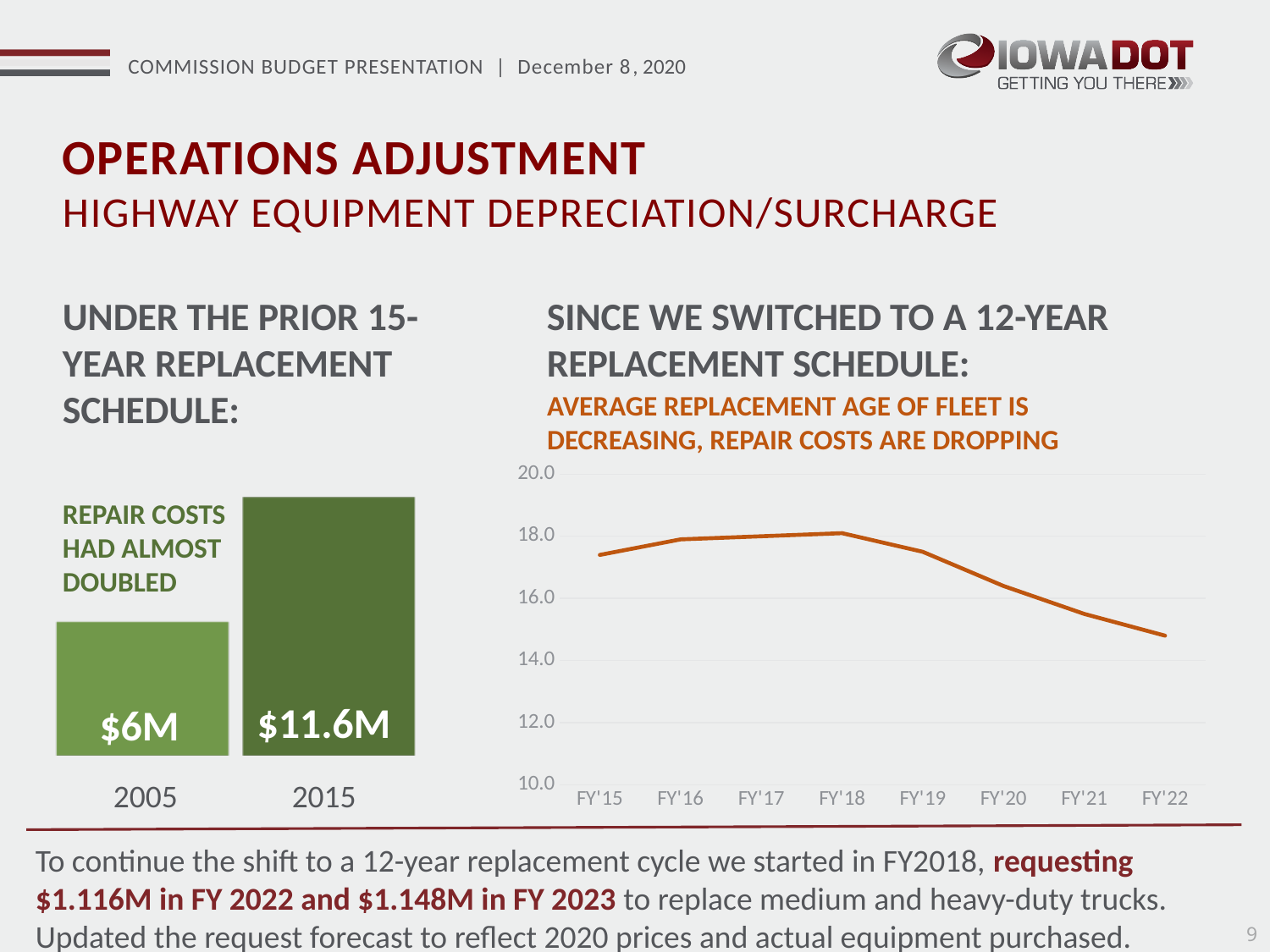
In the bar chart on the left, what were the repair costs in 2005? $6M In the bar chart on the left, which year has the higher repair costs? 2015 How many fiscal years are plotted on the x axis of the line chart on the right? 8 In the bar chart on the left, what were the repair costs in 2015? $11.6M What kind of chart is the chart on the left of the slide? Bar chart What kind of chart is the chart on the right of the slide? Line chart In the line chart on the right, is the value for FY'15 greater or less than 16.0? greater In the line chart on the right, is the value for FY'22 greater or less than 16.0? less How many bars are shown in the bar chart on the left? 2 In the line chart on the right, does the line rise or fall from FY'18 to FY'22? Fall In the bar chart on the left, what is the difference between the 2015 and 2005 repair costs? $5.6M In the line chart on the right, which fiscal year has the lowest value? FY'22